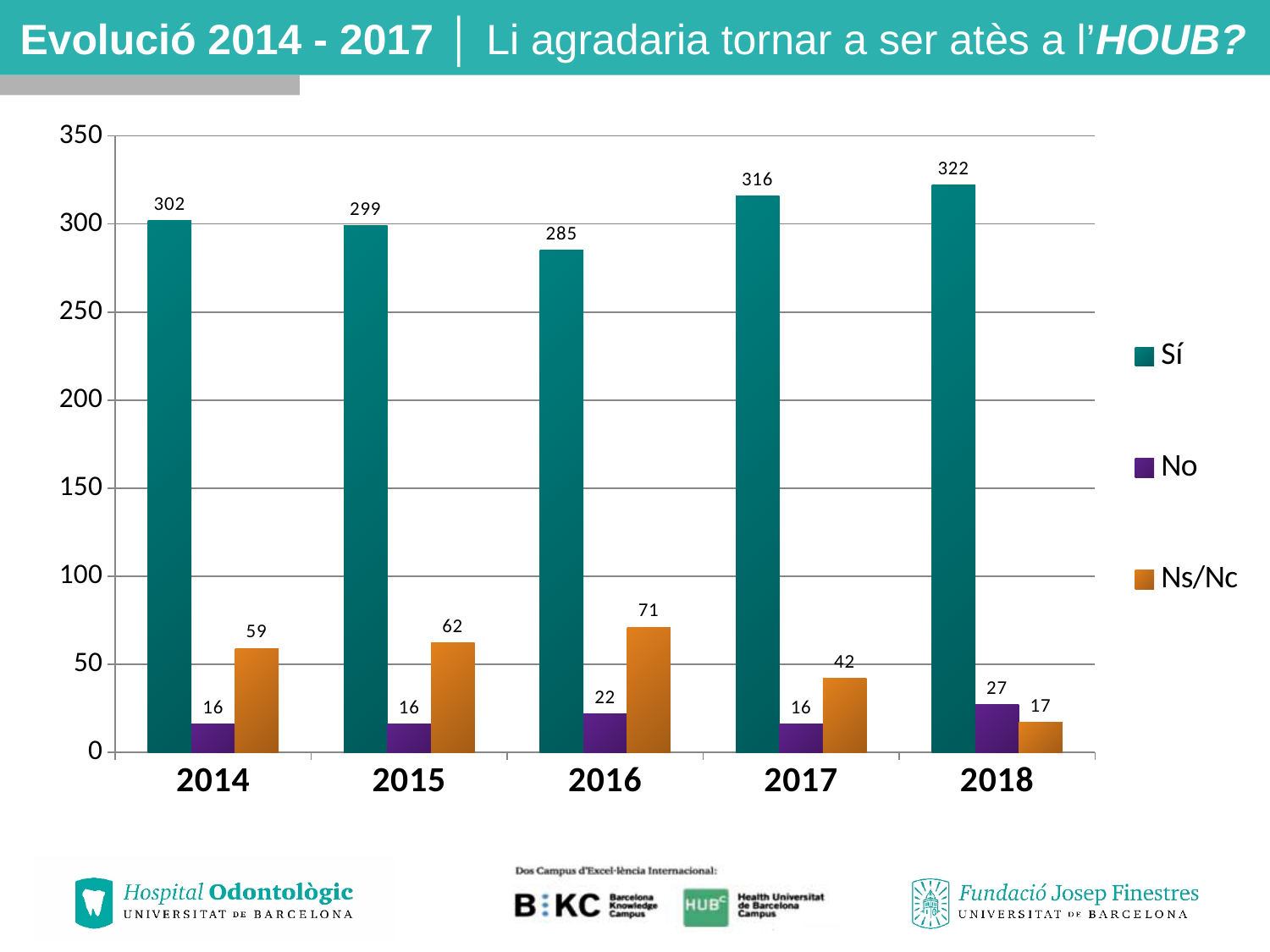
Is the value for Sí in 2017 greater or less than 300? greater What is the value for Ns/Nc in 2015? 62 How many years are shown on the x axis? 5 Which is larger, the Ns/Nc value in 2016 or in 2017? 2016 What is the value for Sí in 2016? 285 What is the difference between the Sí values for 2018 and 2017? 6 What kind of chart is shown on the slide? bar chart Which series is shown in orange in the legend? Ns/Nc In which year is the Ns/Nc value lowest? 2018 In which year is the Sí value highest? 2018 What is the value for No in 2018? 27 How many series does the legend list? 3